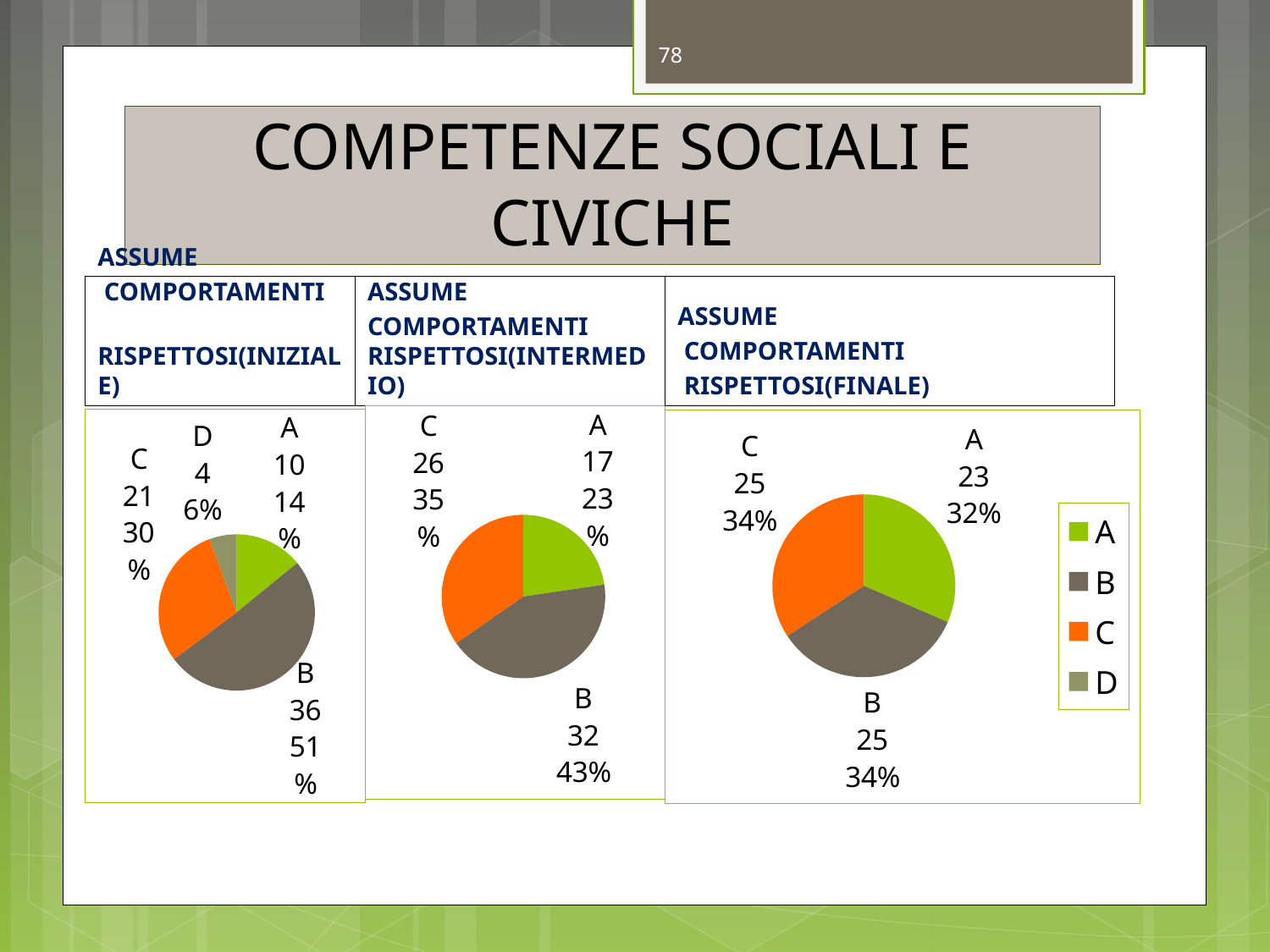
In the left chart (INIZIALE), what percentage share does category D have? 6% In the right chart (FINALE), what is the value for category A? 23 In the middle chart (INTERMEDIO), which category has the largest value? B In the left chart (INIZIALE), which category has the smallest value? D In the right chart (FINALE), which is larger, the value for B or the value for A? B In the middle chart (INTERMEDIO), what percentage share does category B have? 43% What kind of chart is used in the left chart (INIZIALE)? pie chart In the middle chart (INTERMEDIO), what is the difference between the values for B and A? 15 In the left chart (INIZIALE), how many categories are shown? 4 In the middle chart (INTERMEDIO), what is the value for category C? 26 In the left chart (INIZIALE), what is the value for category B? 36 How many entries does the legend on the right chart (FINALE) list? 4